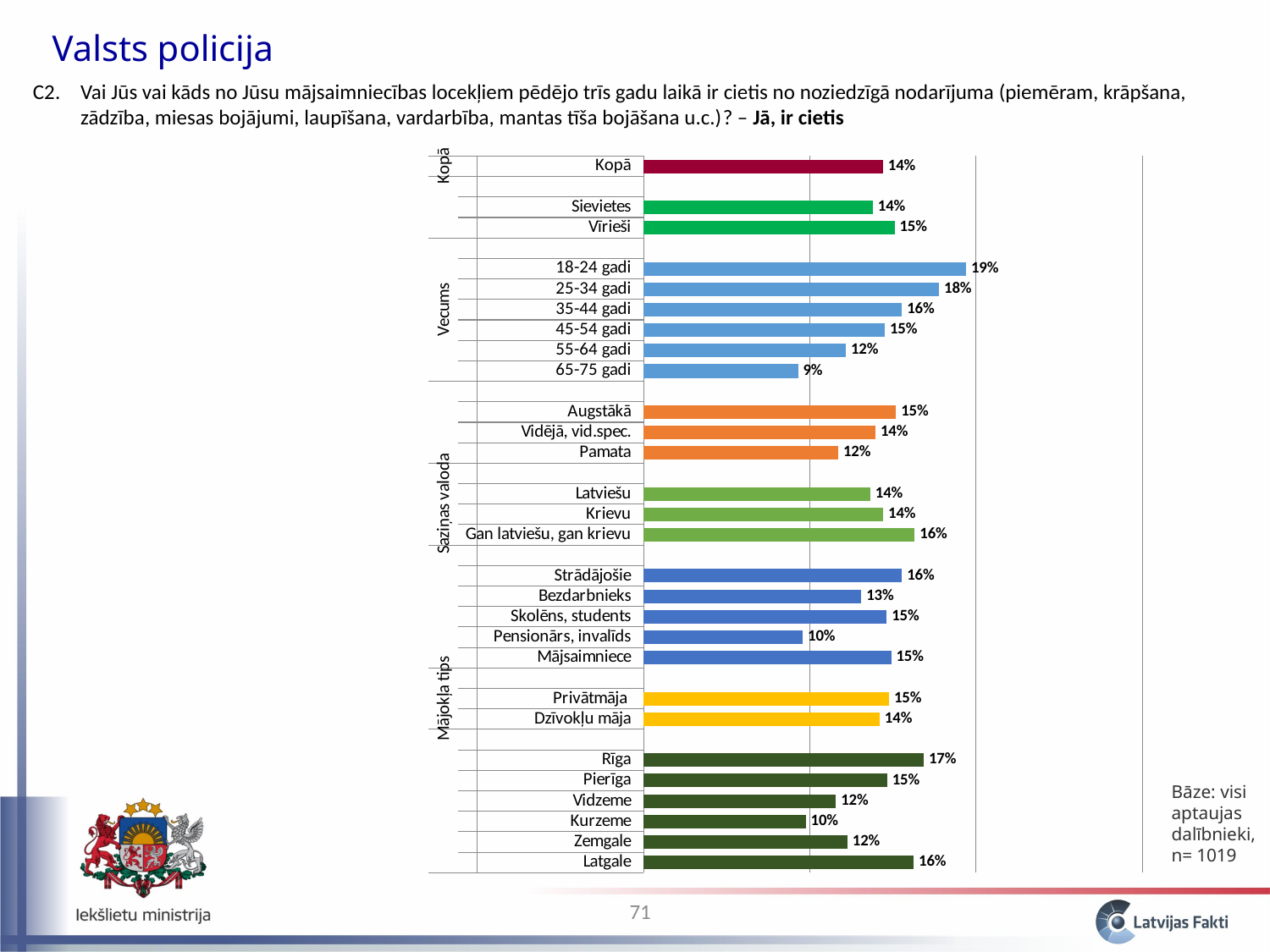
Which category has the highest value in the chart? 18-24 gadi What is the value for Pensionārs, invalīds? 10% What is the difference between the values for Rīga and Kurzeme? 7% What is the value for 18-24 gadi? 19% What is the difference between the values for 25-34 gadi and 55-64 gadi? 6% What kind of chart is shown on the slide? Bar chart Do the values rise or fall as age groups go from 18-24 gadi to 65-75 gadi? Fall What is the value for Kopā? 14% How many bars are plotted in the chart? 28 What is the value for Latgale? 16% Which category has the lowest value in the chart? 65-75 gadi Which is larger, the value for Vīrieši or the value for Sievietes? Vīrieši